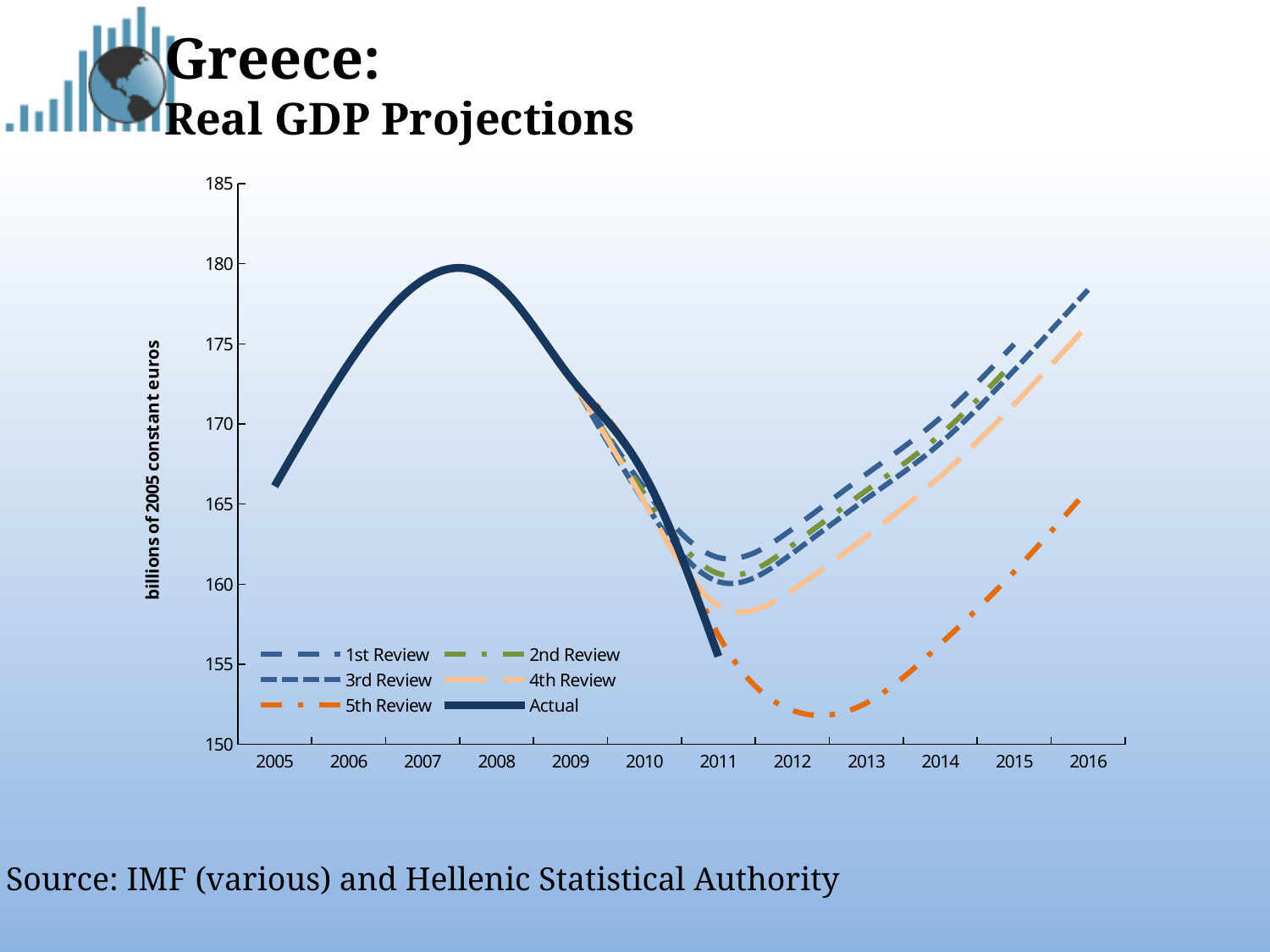
Which series has the lowest value in 2016? 5th Review Is the value of the Actual series in 2007 greater or less than 175? greater Is the value of the 5th Review series in 2012 greater or less than 155? less How many series does the legend list? 6 Is the value of the Actual series in 2011 greater or less than 160? less What is the label on the y axis? billions of 2005 constant euros How many years are labelled on the x axis? 12 Does the Actual series rise or fall between 2008 and 2011? fall What kind of chart is shown on the slide? line chart